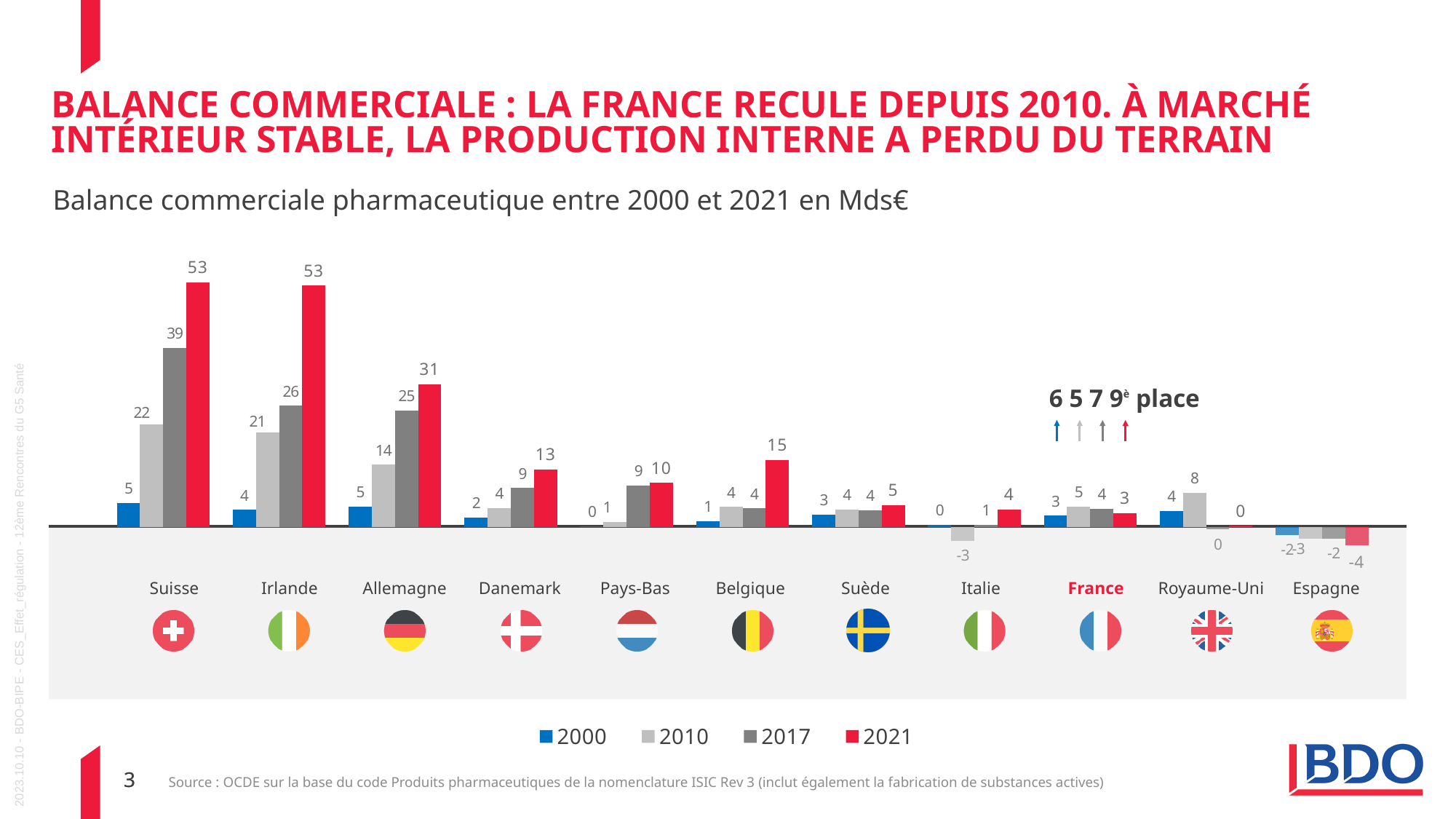
What is the 2010 value for Irlande? 21 Which country has the highest 2017 value? Suisse How many series does the legend list? 4 Which is larger, the 2021 value for Belgique or the 2021 value for Danemark? Belgique What is the 2021 value for Allemagne? 31 How many countries are shown on the chart? 11 What kind of chart is shown on the slide? Bar chart What is the 2021 value for Espagne? -4 What is the 2017 value for Suisse? 39 Which country has the lowest 2021 value? Espagne Do the values for Suisse rise or fall from 2000 to 2021? Rise What is the difference between the 2021 values for Suisse and Allemagne? 22